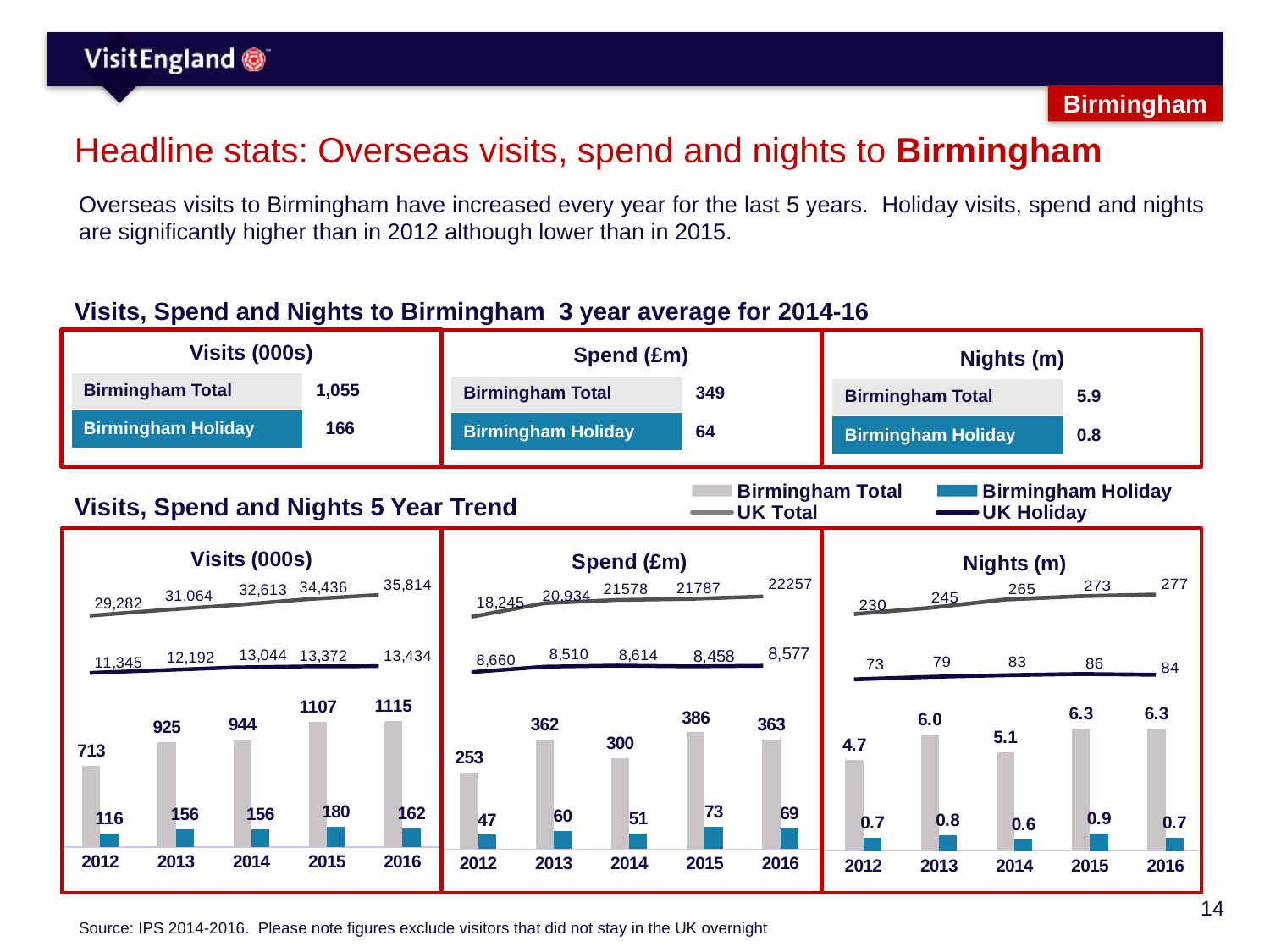
In the Visits (000s) 5 year trend chart, what is the Birmingham Total value for 2016? 1115 In the Nights (m) 5 year trend chart, what is the UK Total value for 2014? 265 In the Spend (£m) 5 year trend chart, is the Birmingham Total value larger in 2013 or 2014? 2013 How many series does the legend for the 5 year trend charts list? 4 How many years are shown on the x axis of the Nights (m) 5 year trend chart? 5 In the Spend (£m) 5 year trend chart, which year has the highest Birmingham Total value? 2015 In the Nights (m) 5 year trend chart, which year has the lowest Birmingham Holiday value? 2014 What kind of chart is the Visits (000s) 5 year trend chart? Combined bar and line chart In the Visits (000s) 5 year trend chart, what is the difference between the Birmingham Total values for 2016 and 2012? 402 In the Spend (£m) 5 year trend chart, what is the Birmingham Holiday value for 2015? 73 In the Spend (£m) 5 year trend chart, what is the UK Holiday value for 2012? 8,660 In the Visits (000s) 5 year trend chart, does the UK Total line rise or fall from 2012 to 2016? Rise